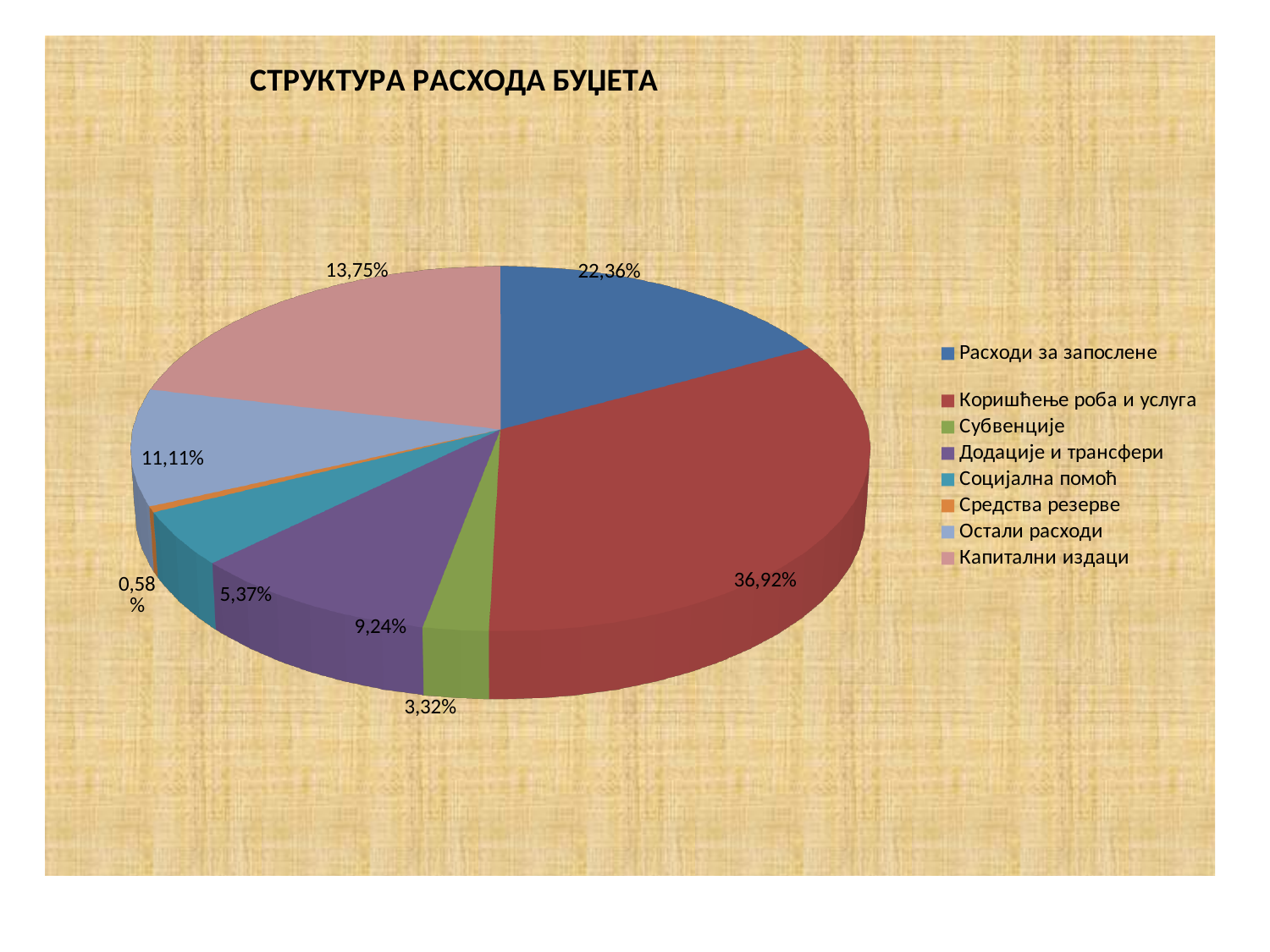
What share of the pie is Расходи за запослене? 22,36% What share of the pie is Капитални издаци? 13,75% What is the title of the chart? СТРУКТУРА РАСХОДА БУЏЕТА Which is larger, the share for Додације и трансфери or the share for Социјална помоћ? Додације и трансфери What share of the pie is Субвенције? 3,32% Which category has the largest share of the pie? Коришћење роба и услуга What kind of chart is shown on the slide? Pie chart What is the difference in percentage points between Коришћење роба и услуга and Расходи за запослене? 14,56 Which category has the smallest share of the pie? Средства резерве How many categories does the legend list? 8